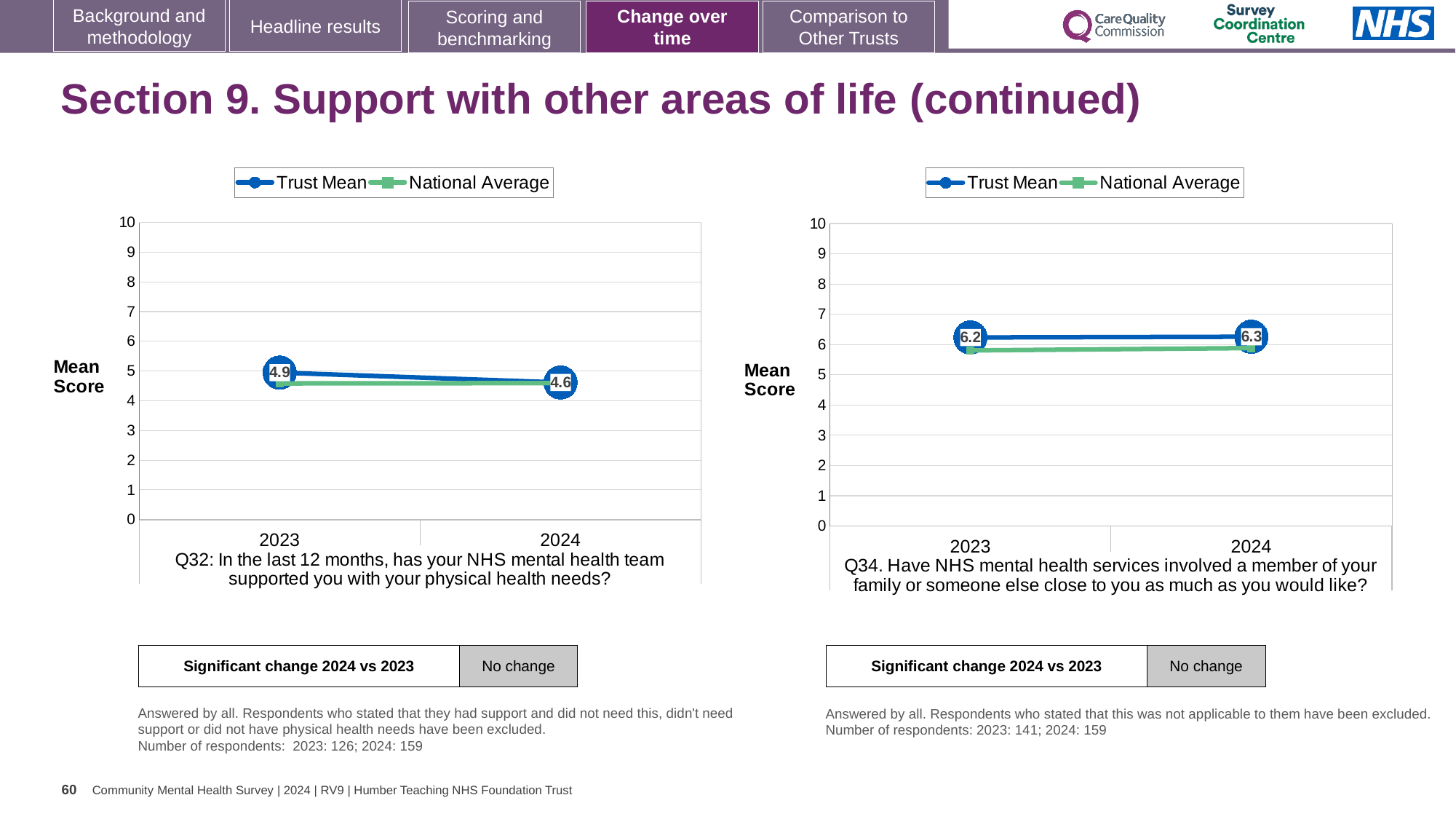
In the right chart (Q34), what is the Trust Mean for 2024? 6.3 In the left chart (Q32), by how much did the Trust Mean change from 2023 to 2024? 0.3 In the right chart (Q34), which series is higher in 2023, Trust Mean or National Average? Trust Mean In the right chart (Q34), is the National Average for 2023 greater or less than 6? less How many series does the legend of the right chart (Q34) list? 2 In the left chart (Q32), does the Trust Mean rise or fall from 2023 to 2024? fall In the left chart (Q32), what is the Trust Mean for 2024? 4.6 In the left chart (Q32), what is the Trust Mean for 2023? 4.9 What kind of chart is the left chart (Q32)? line chart In the right chart (Q34), does the Trust Mean rise or fall from 2023 to 2024? rise In the right chart (Q34), what is the Trust Mean for 2023? 6.2 How many years are plotted on the x axis of the left chart (Q32)? 2